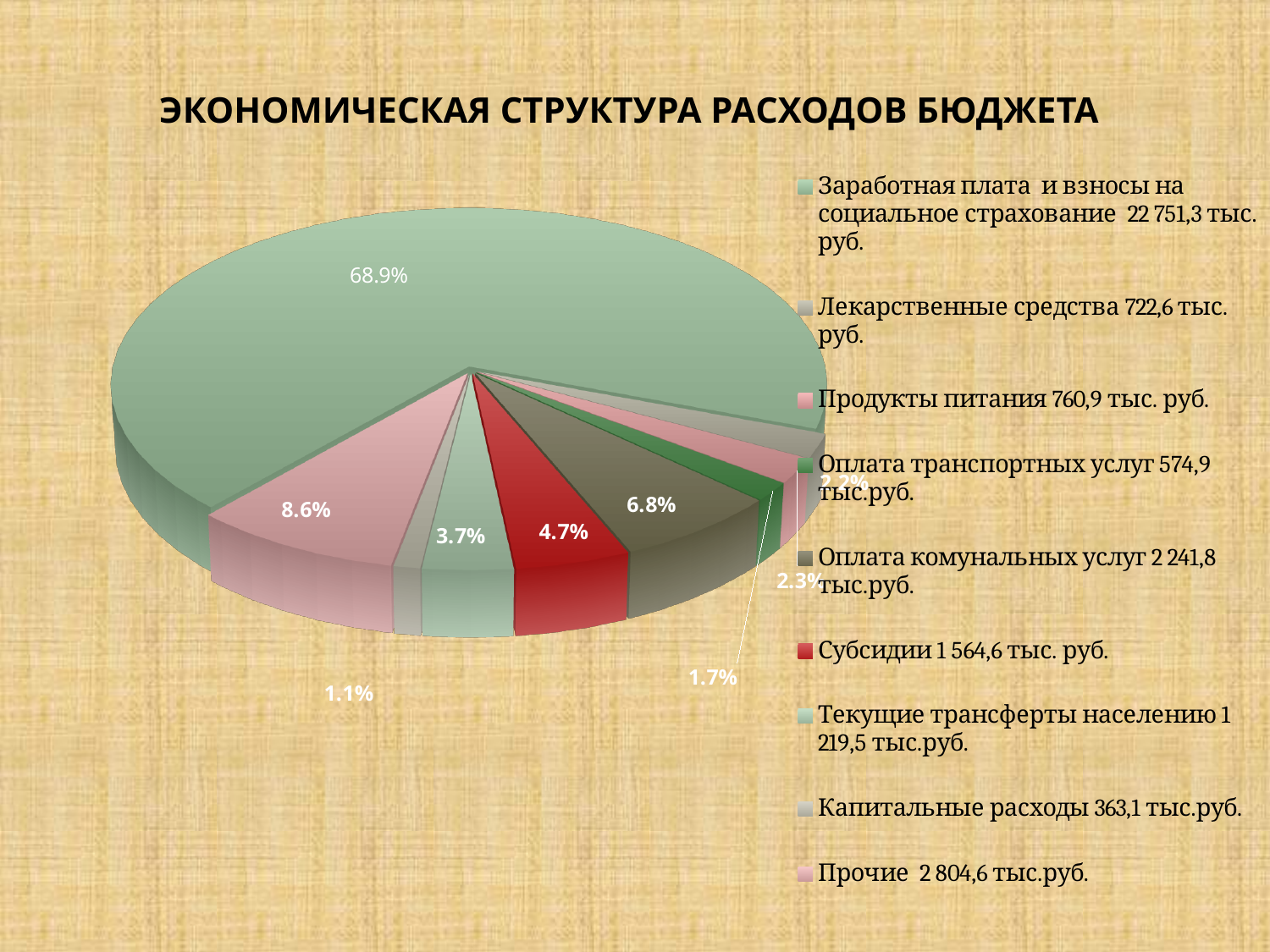
What share of the pie is labelled for Прочие? 8.6% What share of the pie is labelled for Субсидии? 4.7% Which category has the smallest amount according to the legend? Капитальные расходы Which category has the largest share of the pie? Заработная плата и взносы на социальное страхование How many categories does the legend of the pie chart list? 9 Which is larger: the share for Субсидии or the share for Текущие трансферты населению? Субсидии What is the title of the chart? ЭКОНОМИЧЕСКАЯ СТРУКТУРА РАСХОДОВ БЮДЖЕТА What is the difference in percentage points between the share for Заработная плата и взносы на социальное страхование and the share for Прочие? 60.3 percentage points What share of the pie is labelled for Заработная плата и взносы на социальное страхование? 68.9% What kind of chart is shown on the slide? Pie chart What amount does the legend give for Лекарственные средства? 722,6 тыс. руб.